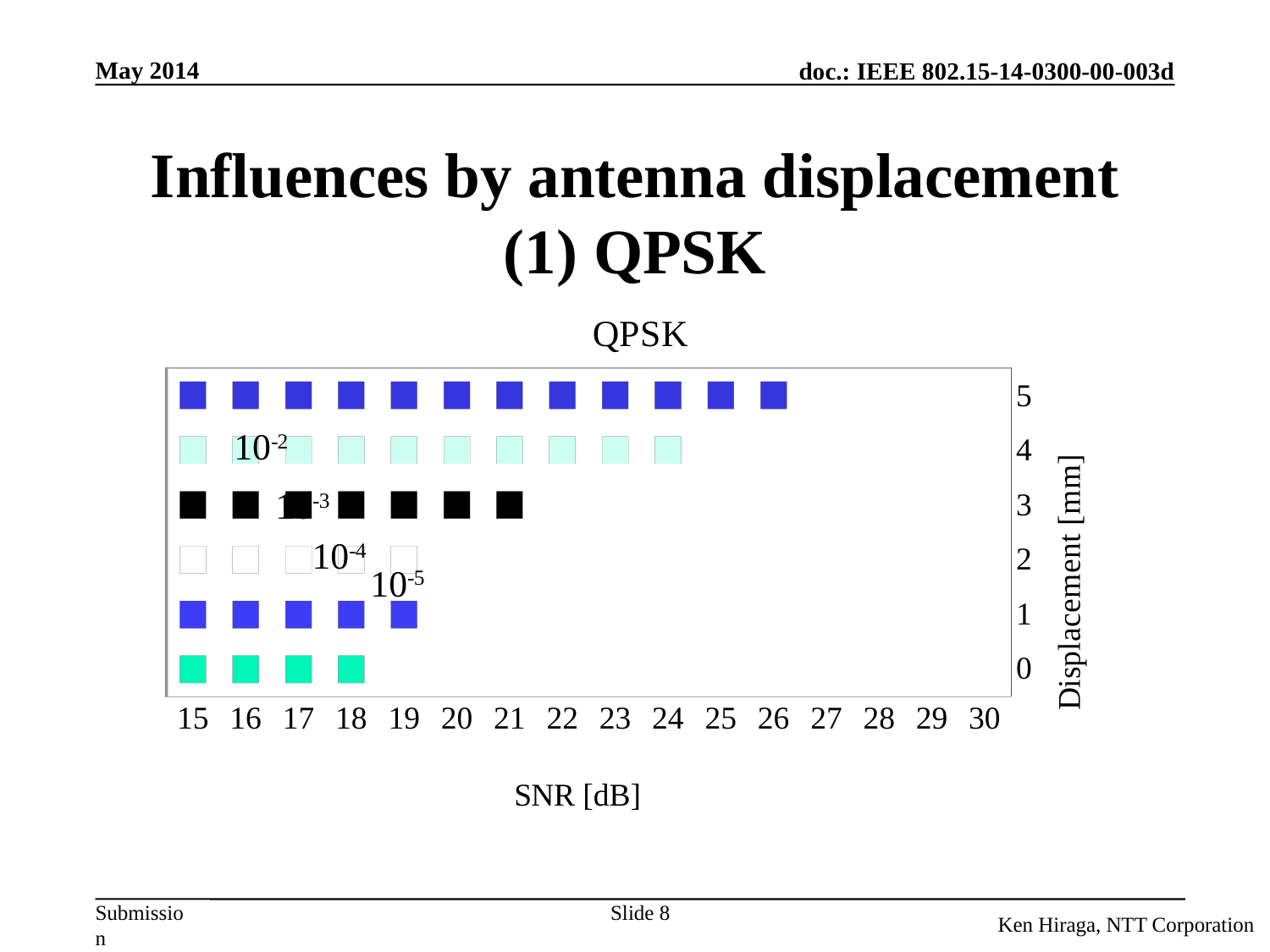
How many markers are plotted for displacement 5 mm? 12 What is the highest SNR value at which a marker is plotted for displacement 0 mm? 18 Does the row of markers for displacement 4 mm or displacement 2 mm extend to a higher SNR? 4 mm Which displacement level has the fewest markers? 0 As displacement increases from 0 to 5 mm, does the number of plotted markers rise or fall? rise How many displacement levels are plotted on the y axis? 6 What is the title of the chart? QPSK What is the label of the x axis? SNR [dB] What kind of chart is shown on the slide? surface (contour) chart Which displacement level has markers extending to the highest SNR? 5 What is the highest SNR value at which a marker is plotted for displacement 3 mm? 21 What is the highest SNR value at which a marker is plotted for displacement 5 mm? 26